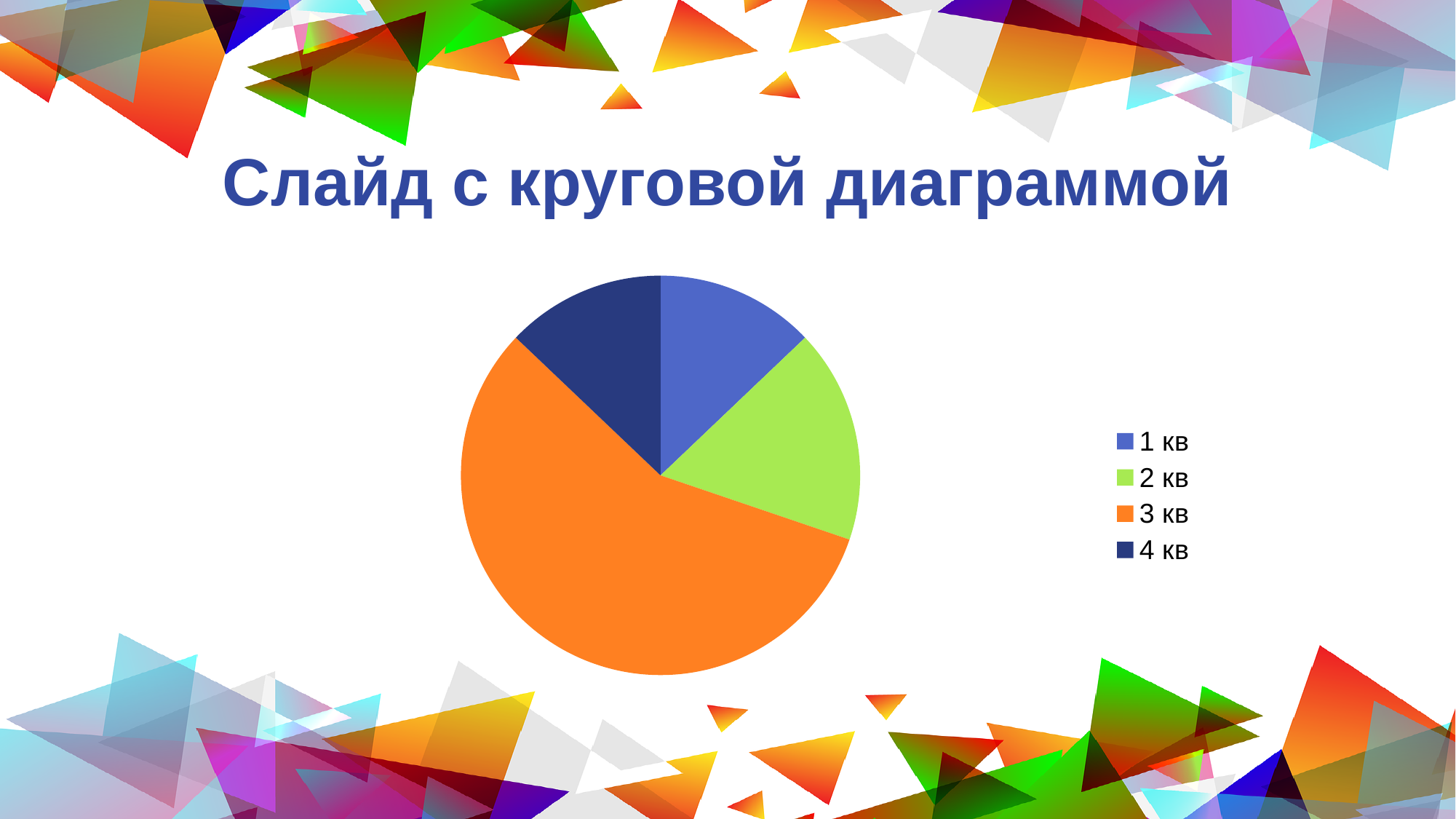
Does the 3 кв slice take up more or less than half of the pie? more What is the title of the slide? Слайд с круговой диаграммой Which slice is larger, 3 кв or 2 кв? 3 кв How many slices does the pie chart have? 4 Which slice is larger, 3 кв or 4 кв? 3 кв What kind of chart is shown on the slide? pie chart What colour is the 3 кв slice in the pie chart? orange How many entries does the legend list? 4 Which category has the largest slice of the pie? 3 кв